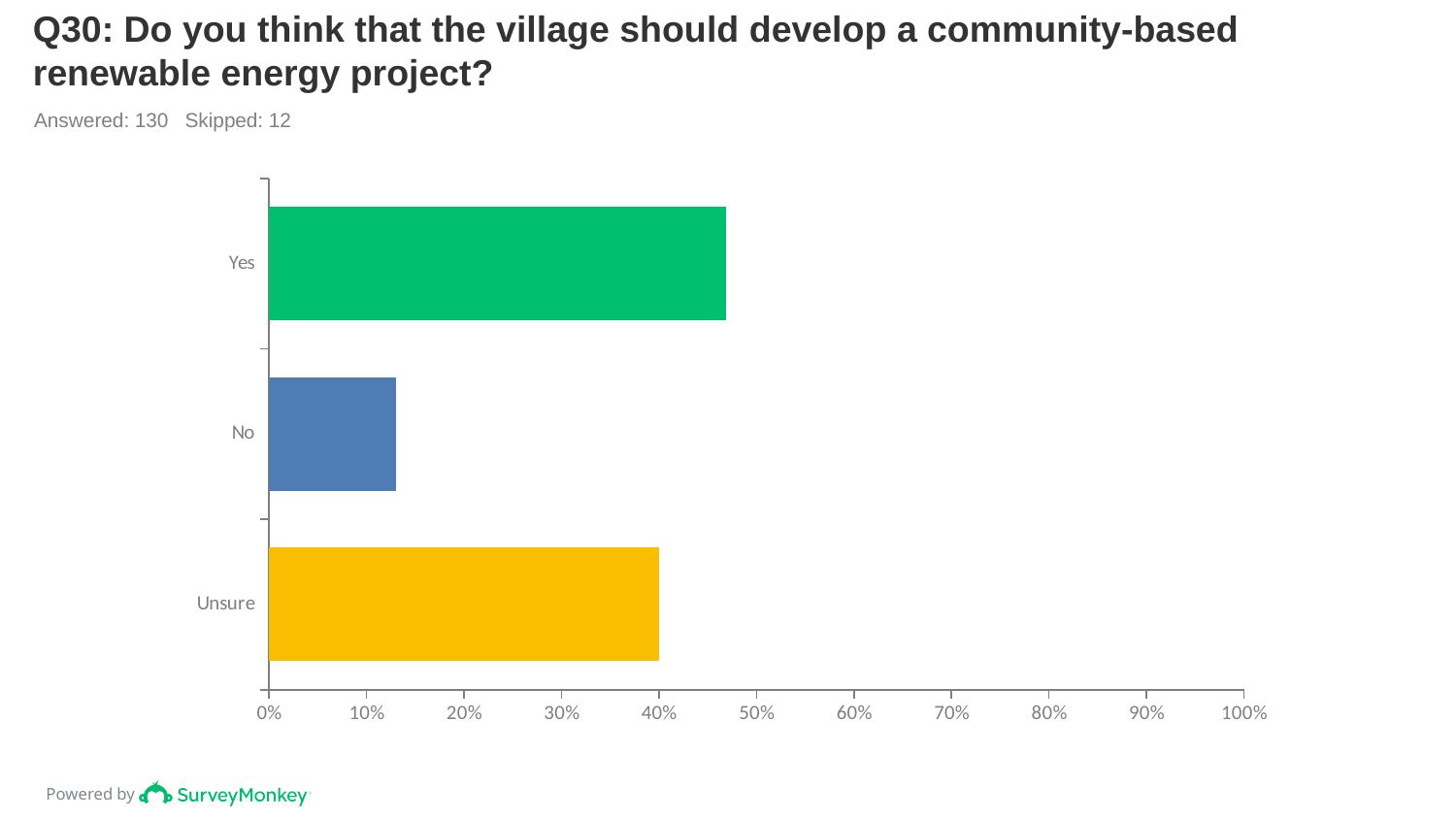
Is the value for Unsure greater or less than 50%? less Which response category has the highest value? Yes How many response categories are shown in the chart? 3 What colour is the bar for Yes? green What kind of chart is shown on the slide? bar chart Is the value for No greater or less than 20%? less How many respondents answered this question, according to the slide? 130 Is the value for Yes greater or less than 40%? greater Which response category has the lowest value? No Which is larger, the value for Unsure or the value for No? Unsure